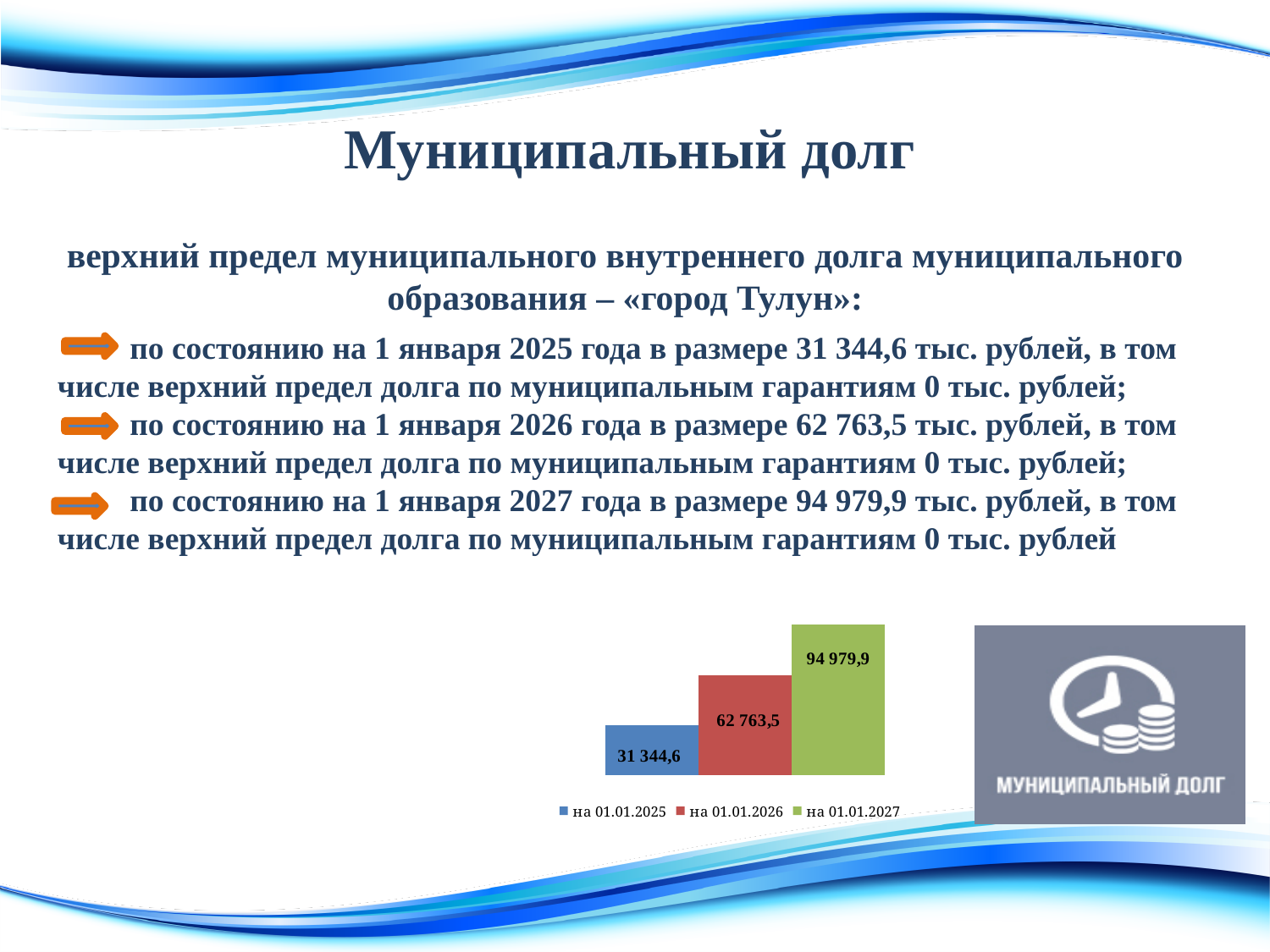
Do the values in the chart rise or fall from на 01.01.2025 to на 01.01.2027? rise Which legend entry has the highest value in the chart? на 01.01.2027 What is the difference between the values for на 01.01.2026 and на 01.01.2025? 31 418,9 What value does the chart show for на 01.01.2027? 94 979,9 What is the difference between the values for на 01.01.2027 and на 01.01.2026? 32 216,4 What value does the chart show for на 01.01.2026? 62 763,5 Which legend entry has the lowest value in the chart? на 01.01.2025 Which is larger: the value for на 01.01.2026 or the value for на 01.01.2027? на 01.01.2027 What kind of chart is shown on the slide? bar chart What value does the chart show for на 01.01.2025? 31 344,6 How many entries does the chart legend list? 3 How many bars are plotted in the chart? 3